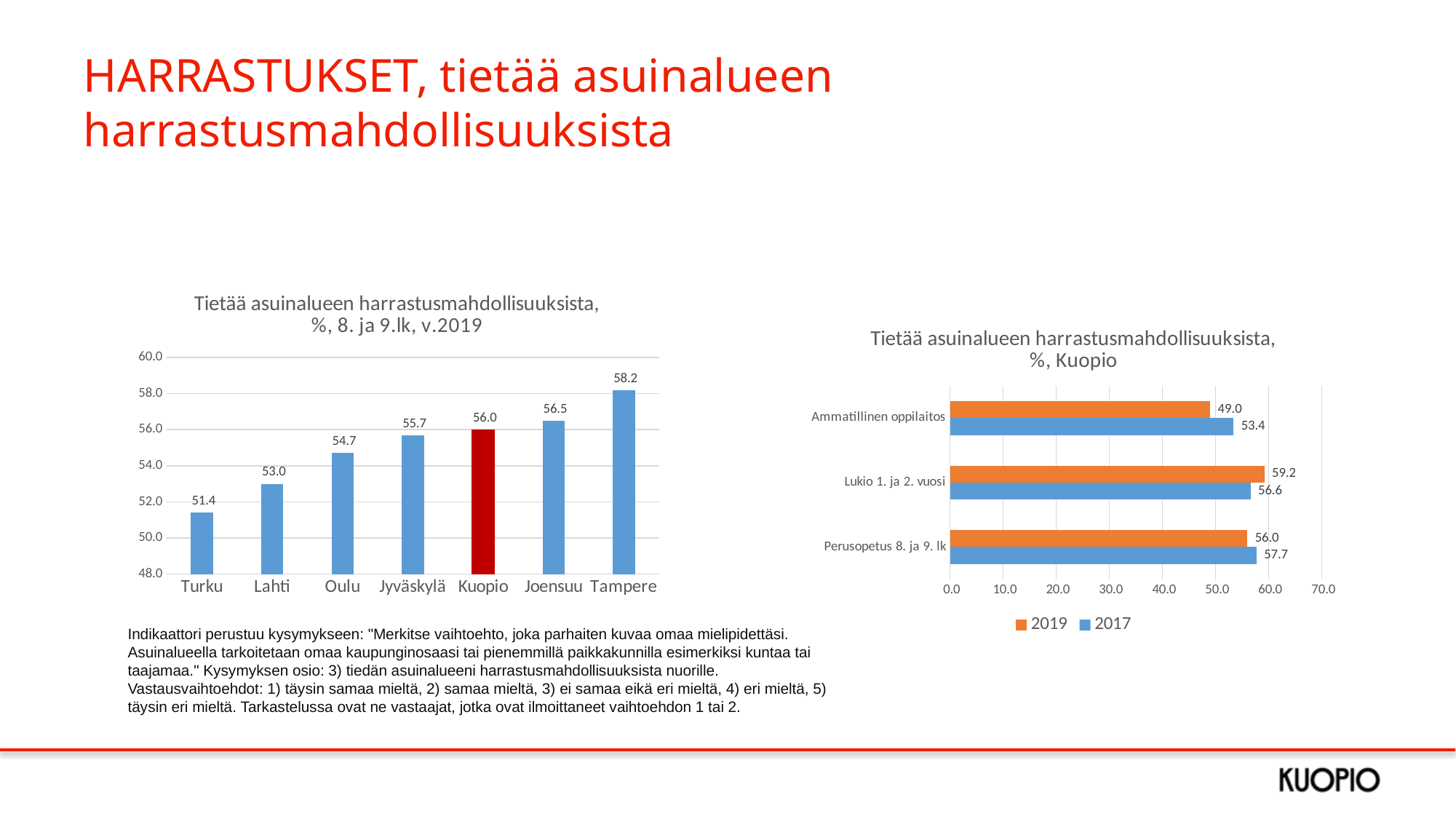
In the right chart (%, Kuopio), which is larger for Perusopetus 8. ja 9. lk: the 2019 value or the 2017 value? 2017 In the right chart (%, Kuopio), how many series does the legend list? 2 In the left chart (8. ja 9.lk, v.2019), how many cities are shown? 7 In the right chart (%, Kuopio), what is the 2017 value for Lukio 1. ja 2. vuosi? 56.6 What kind of chart is the right chart (%, Kuopio)? bar chart In the left chart (8. ja 9.lk, v.2019), which city has the lowest value? Turku In the right chart (Tietää asuinalueen harrastusmahdollisuuksista, %, Kuopio), what is the 2019 value for Ammatillinen oppilaitos? 49.0 In the left chart (8. ja 9.lk, v.2019), which bar is coloured red? Kuopio In the left chart (8. ja 9.lk, v.2019), do the values rise or fall from Turku to Tampere? rise In the left chart (Tietää asuinalueen harrastusmahdollisuuksista, %, 8. ja 9.lk, v.2019), what is the value for Kuopio? 56.0 In the left chart (8. ja 9.lk, v.2019), which city has the highest value? Tampere In the left chart (8. ja 9.lk, v.2019), what is the difference between Tampere and Turku? 6.8